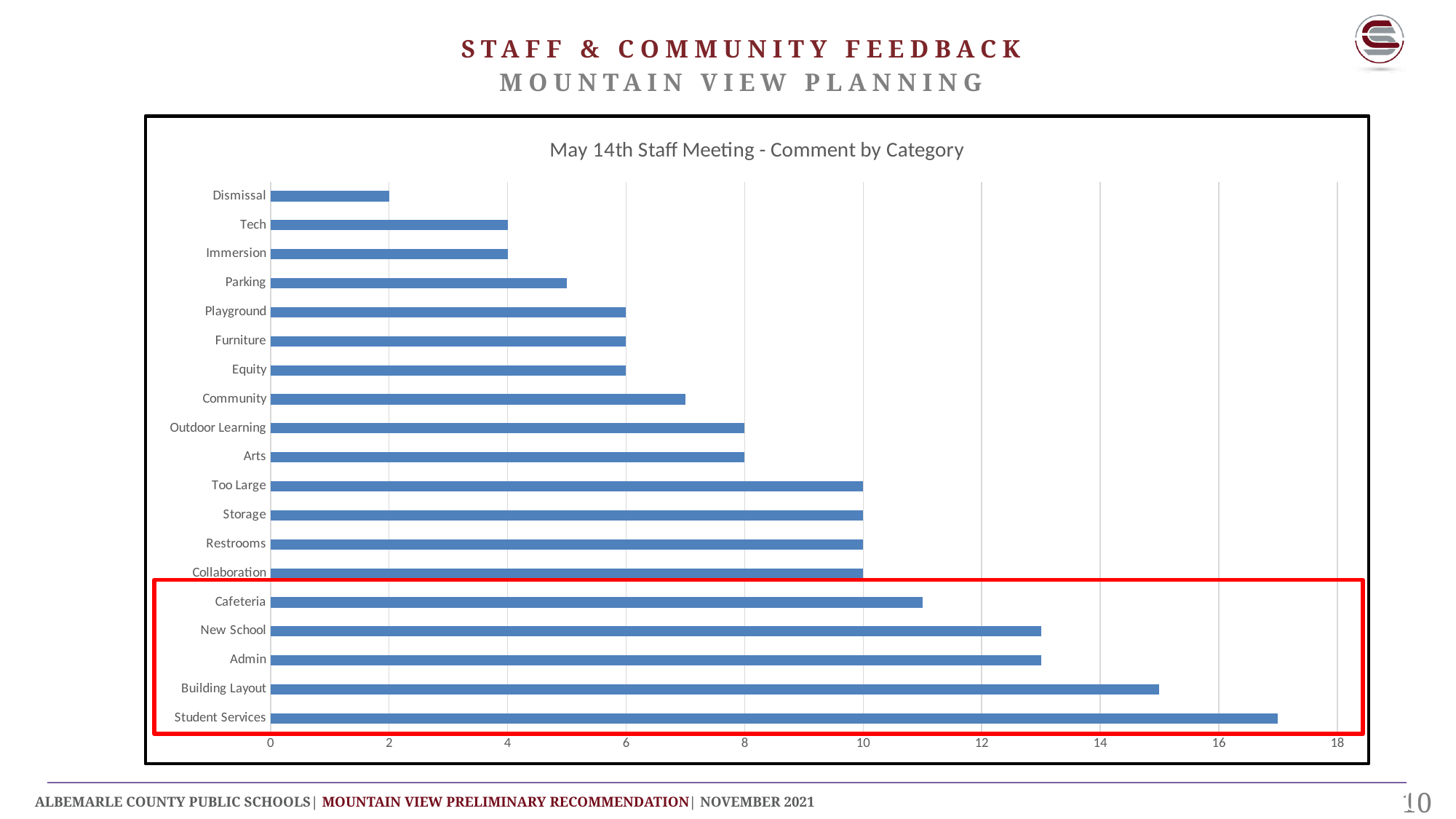
What is the value for Tech? 4 What is the value for Outdoor Learning? 8 What is the value for Collaboration? 10 What is the value for Dismissal? 2 What kind of chart is shown on the slide? bar chart Is the value for Student Services greater or less than 16? greater How many categories are plotted in the chart? 19 What is the title of the chart? May 14th Staff Meeting - Comment by Category What is the difference between the values for Collaboration and Dismissal? 8 Which category has the highest number of comments? Student Services Which is larger, the value for Building Layout or the value for Admin? Building Layout Which category has the lowest number of comments? Dismissal